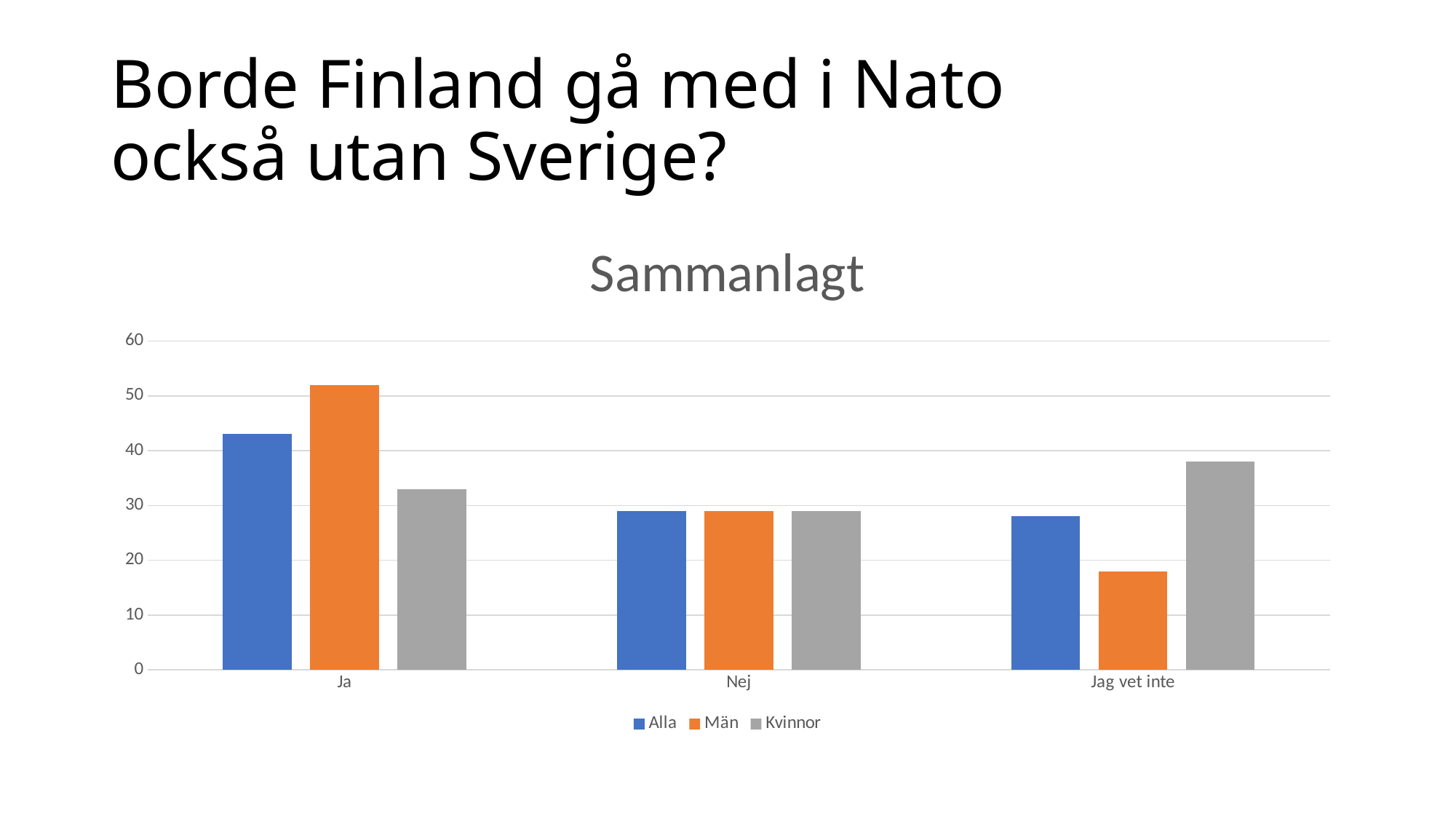
Is the value for Alla in the category Ja greater or less than 40? greater How many series does the legend list? 3 Which series has the lowest value for the category Jag vet inte? Män Which series has the highest value for the category Ja? Män What is the title of the chart? Sammanlagt Is the value for Män in the category Jag vet inte greater or less than 20? less Which series has the highest value for the category Jag vet inte? Kvinnor Is the value for Kvinnor in the category Jag vet inte greater or less than 30? greater What kind of chart is shown on the slide? bar chart How many categories are shown on the x axis? 3 Which series has the lowest value for the category Ja? Kvinnor Which is larger for the category Ja: the value for Alla or the value for Kvinnor? Alla